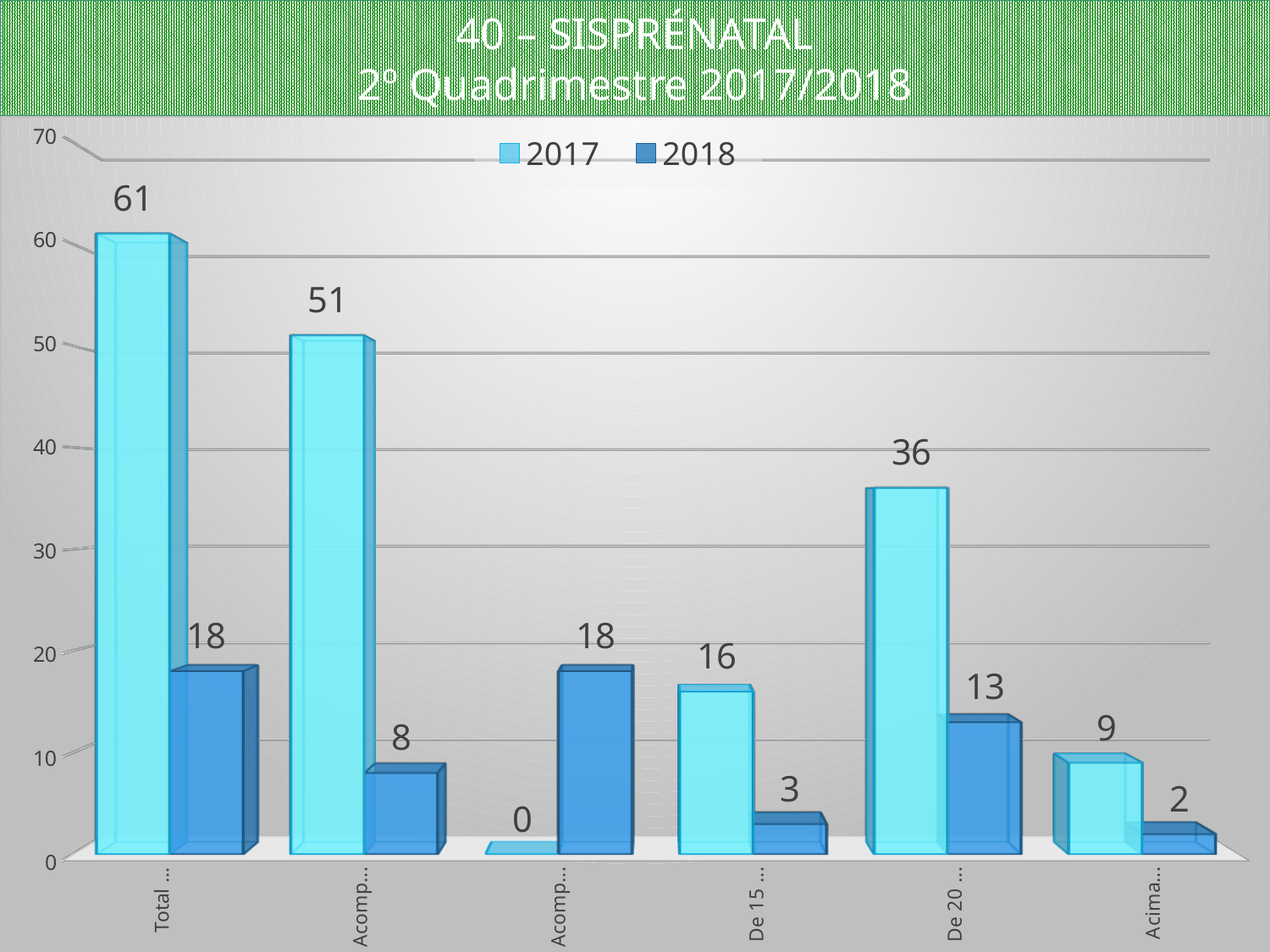
What is the 2017 value for the first category ("Total ...")? 61 What are the two entries in the legend? 2017 and 2018 What is the 2018 value for the category labelled "De 15 ..."? 3 For the third category, which series has the larger value, 2017 or 2018? 2018 What type of chart is shown on the slide? bar chart How many series does the legend list? 2 Which category has the lowest 2017 value? the third category (Acomp...), with 0 What is the difference between the 2017 and 2018 values for the first category ("Total ...")? 43 What is the 2017 value for the last category ("Acima...")? 9 Which category has the highest 2017 value? Total ... (the first category) What is the 2018 value for the category labelled "De 20 ..."? 13 How many categories are shown along the x axis? 6